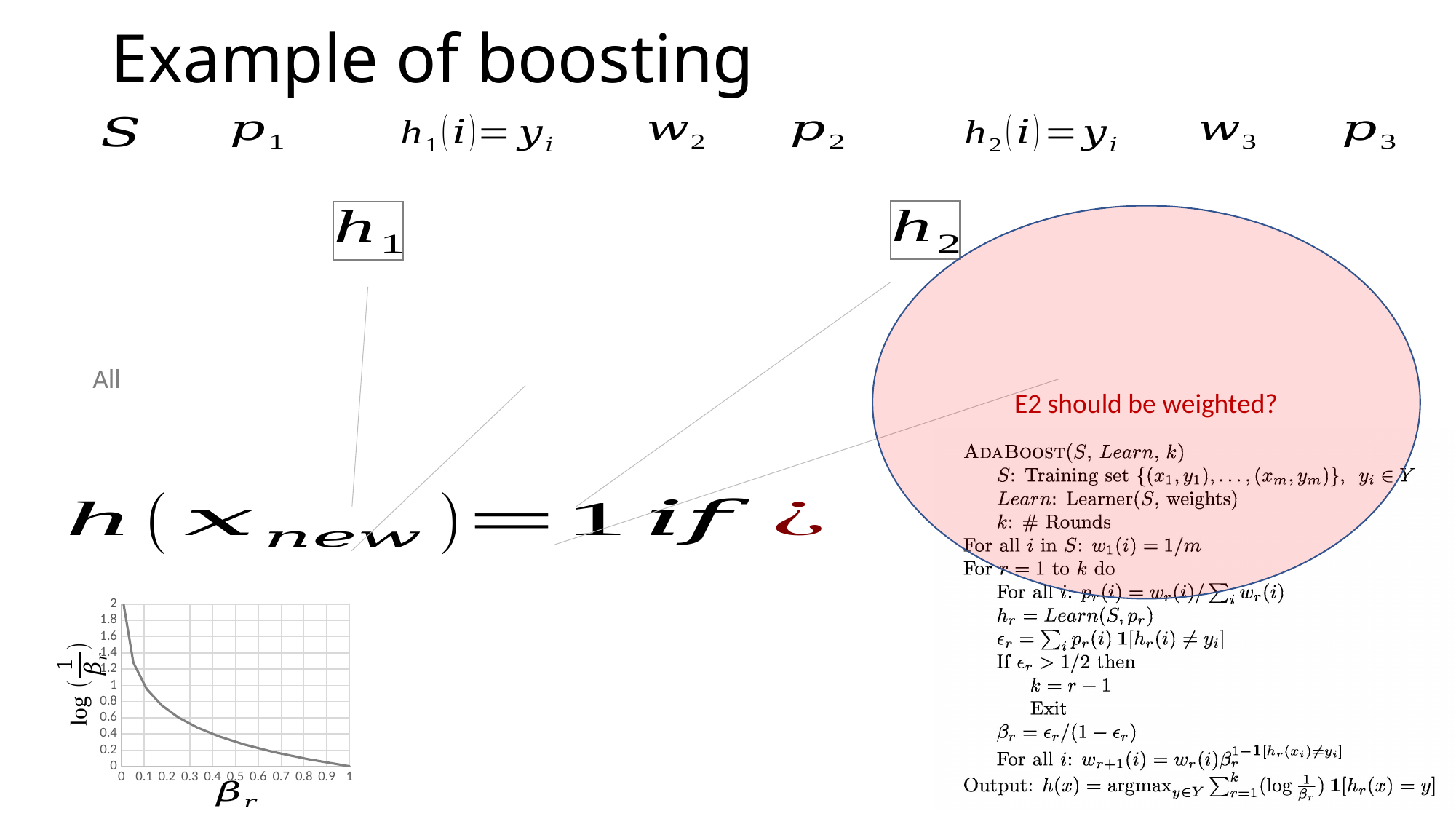
In the bottom-left chart, is the value at β_r = 0.1 greater or less than 0.8? greater In the bottom-left chart, how many tick marks are labelled on the x axis from 0 to 1? 11 In the bottom-left chart, what is the label on the y axis? log(1/β_r) In the bottom-left chart, what is the highest value shown on the y axis? 2 In the bottom-left chart, is the value at β_r = 0.9 greater or less than 0.2? less In the bottom-left chart, at which end of the β_r axis is the curve at its lowest? β_r = 1 In the bottom-left chart, is the value at β_r = 0.5 greater or less than 0.6? less In the bottom-left chart, does the plotted value rise or fall as β_r increases from 0 to 1? fall What kind of chart is shown at the bottom left of the slide? line chart In the bottom-left chart, which is larger, the value at β_r = 0.2 or the value at β_r = 0.8? β_r = 0.2 In the bottom-left chart, what is the label on the x axis? β_r